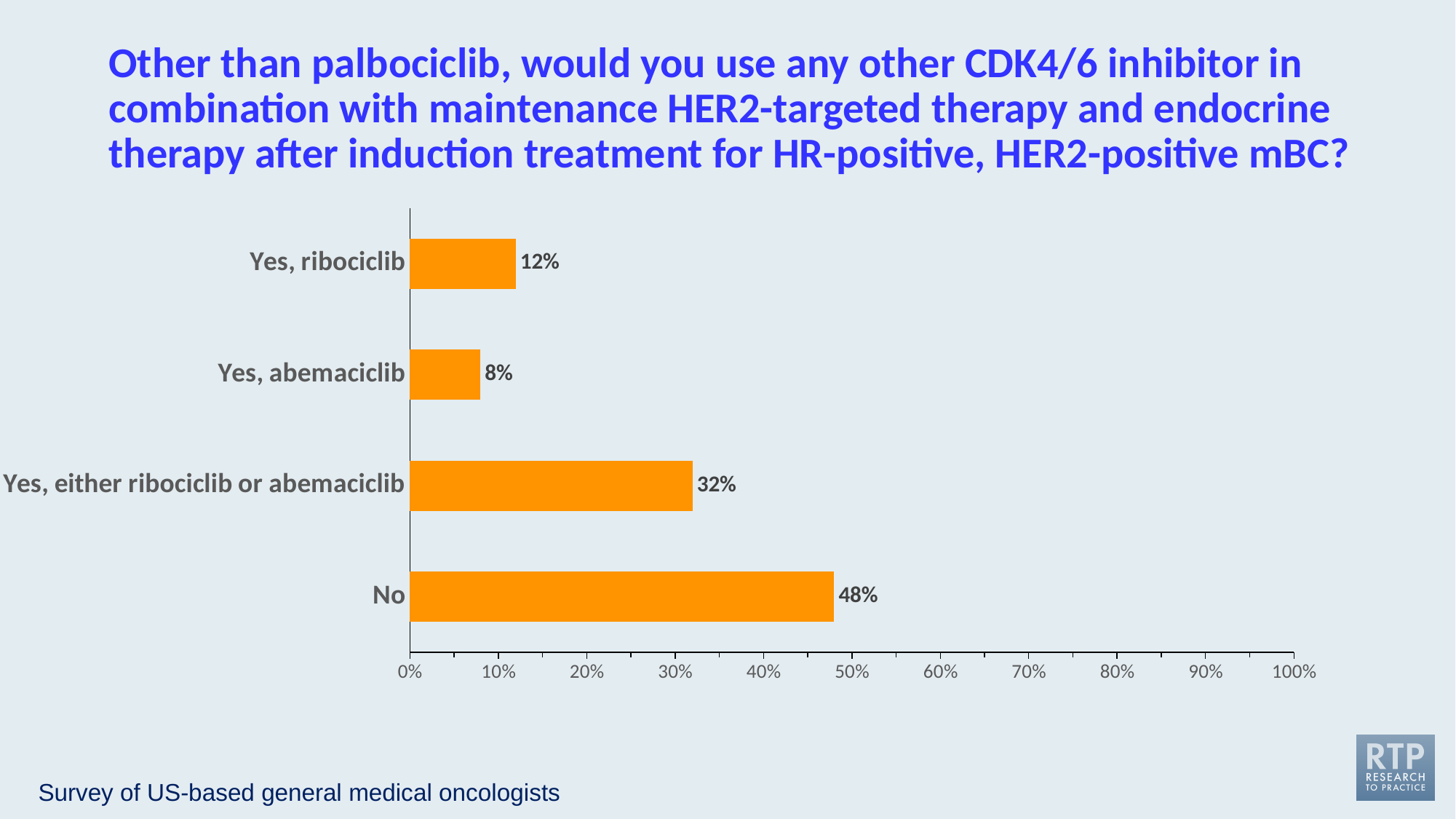
Is the value for "No" greater or less than 50%? less How many response categories are shown in the chart? 4 Which response category has the lowest percentage? Yes, abemaciclib What percentage of respondents answered "No"? 48% What type of chart is shown on the slide? Bar chart What percentage of respondents answered "Yes, abemaciclib"? 8% Which is larger: the percentage for "Yes, ribociclib" or for "Yes, abemaciclib"? Yes, ribociclib What percentage of respondents answered "Yes, ribociclib"? 12% What percentage of respondents answered "Yes, either ribociclib or abemaciclib"? 32% Which response category has the highest percentage? No What is the difference in percentage points between "Yes, ribociclib" and "Yes, abemaciclib"? 4% What is the difference in percentage points between "No" and "Yes, either ribociclib or abemaciclib"? 16%